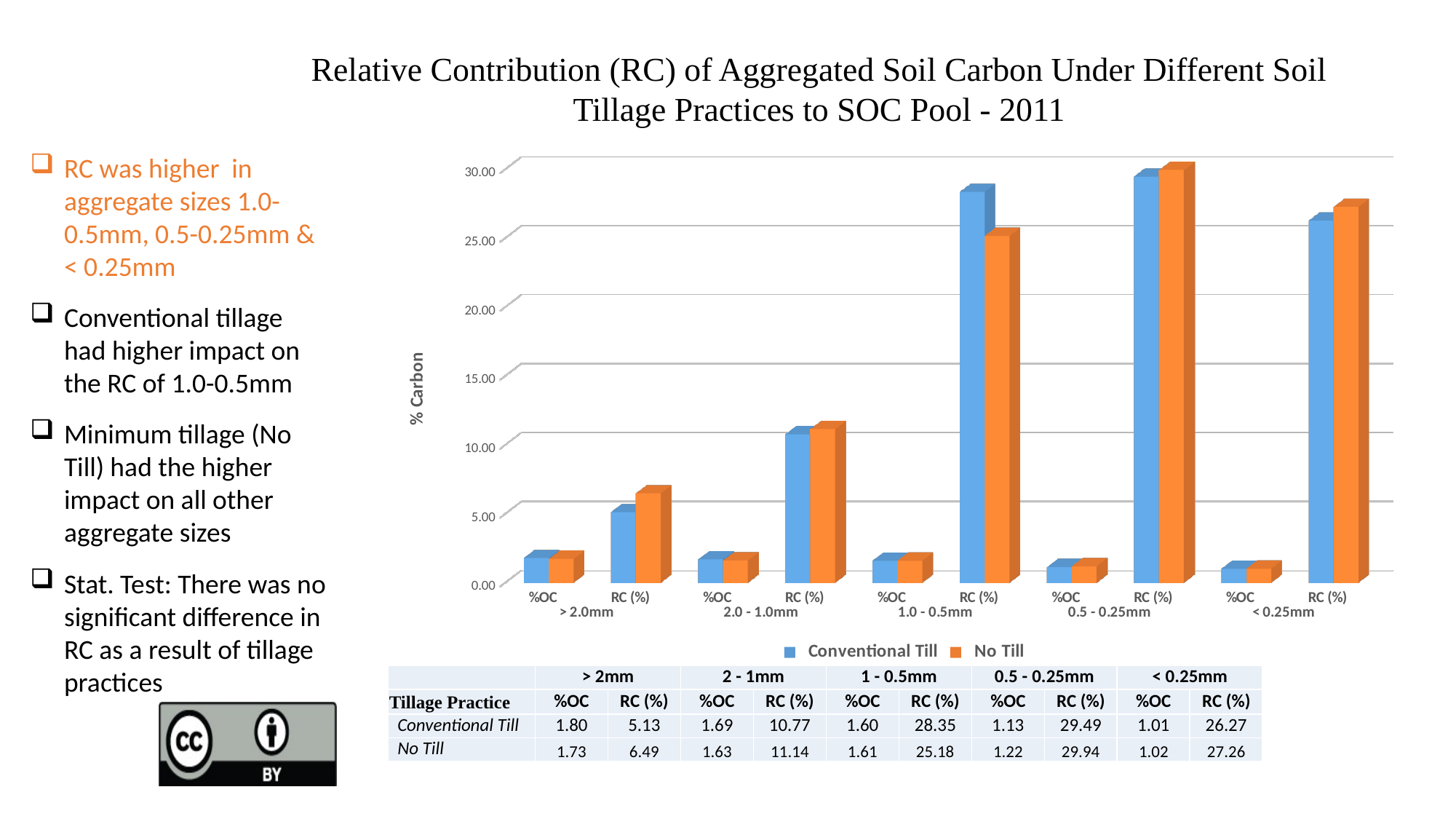
How many aggregate size groups are shown on the x axis of the chart? 5 What kind of chart is shown on the slide? bar chart How many series does the chart legend list? 2 For Conventional Till, which aggregate size has the lowest RC (%)? > 2mm What is the title of the chart's vertical axis? % Carbon For No Till, which aggregate size has the highest RC (%)? 0.5 - 0.25mm What is the difference between the No Till and Conventional Till RC (%) values in the > 2mm aggregate size? 1.36 In the 1.0 - 0.5mm aggregate size, which series has the larger RC (%): Conventional Till or No Till? Conventional Till Is the RC (%) value for Conventional Till in the 0.5 - 0.25mm aggregate size greater or less than 25.00? greater What is the %OC value for Conventional Till in the > 2mm aggregate size? 1.80 What is the RC (%) value for Conventional Till in the 1.0 - 0.5mm aggregate size? 28.35 What is the RC (%) value for No Till in the < 0.25mm aggregate size? 27.26